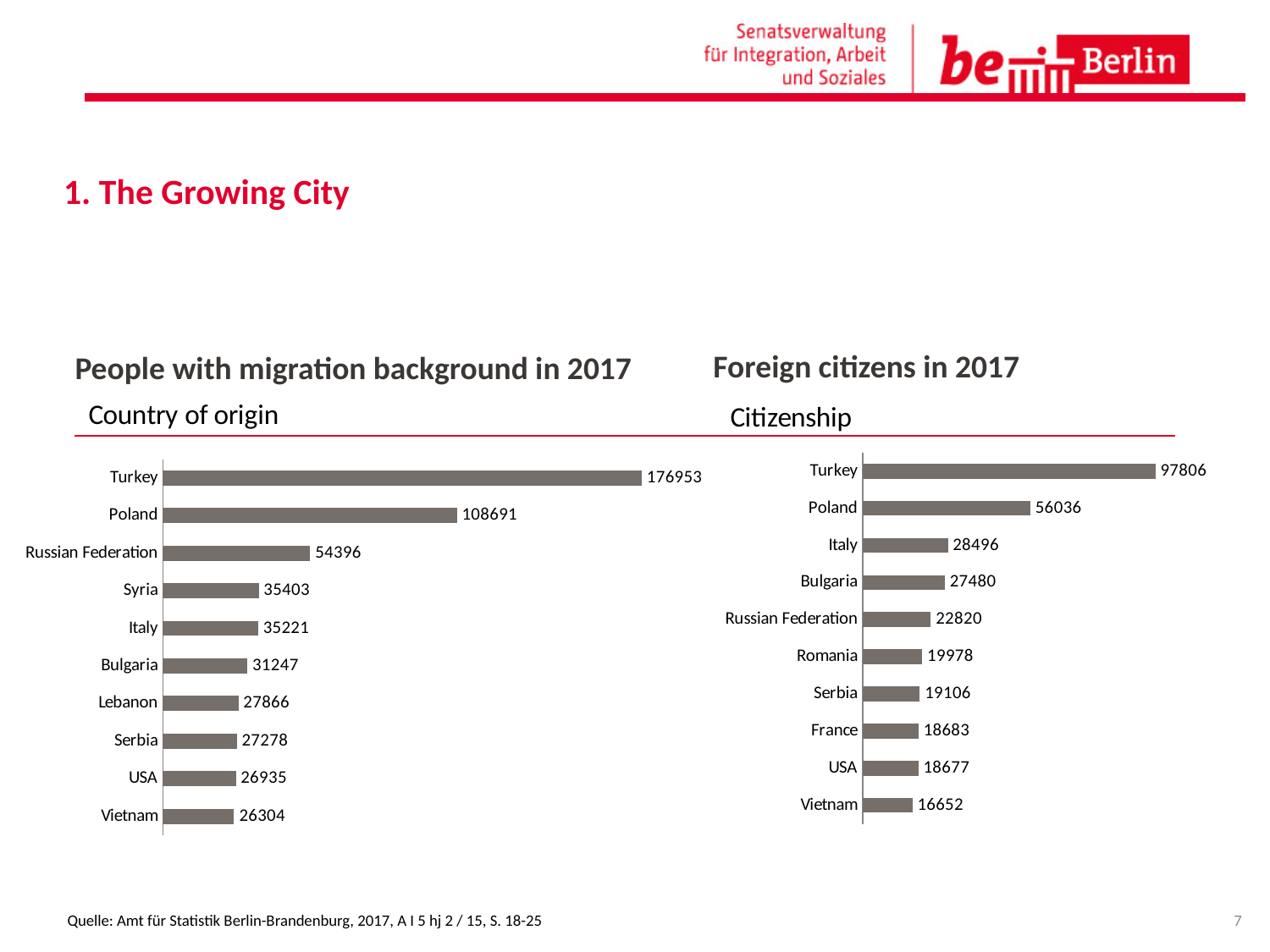
In the 'Foreign citizens in 2017' chart, what is the difference between the values for Turkey and Poland? 41770 In the 'People with migration background in 2017' chart, what is the value for Lebanon? 27866 In the 'Foreign citizens in 2017' chart, which is larger, the value for Italy or the value for Russian Federation? Italy What kind of chart is the 'Foreign citizens in 2017' chart? Bar chart How many countries are shown in the 'People with migration background in 2017' chart? 10 How many citizenships are shown in the 'Foreign citizens in 2017' chart? 10 In the 'People with migration background in 2017' chart, what is the difference between the values for Turkey and Poland? 68262 In the 'Foreign citizens in 2017' chart, what is the value for Bulgaria? 27480 In the 'People with migration background in 2017' chart, what is the value for Poland? 108691 In the 'People with migration background in 2017' chart, which is larger, the value for Russian Federation or the value for Syria? Russian Federation In the 'Foreign citizens in 2017' chart, which citizenship has the lowest value? Vietnam In the 'People with migration background in 2017' chart, which country of origin has the highest value? Turkey